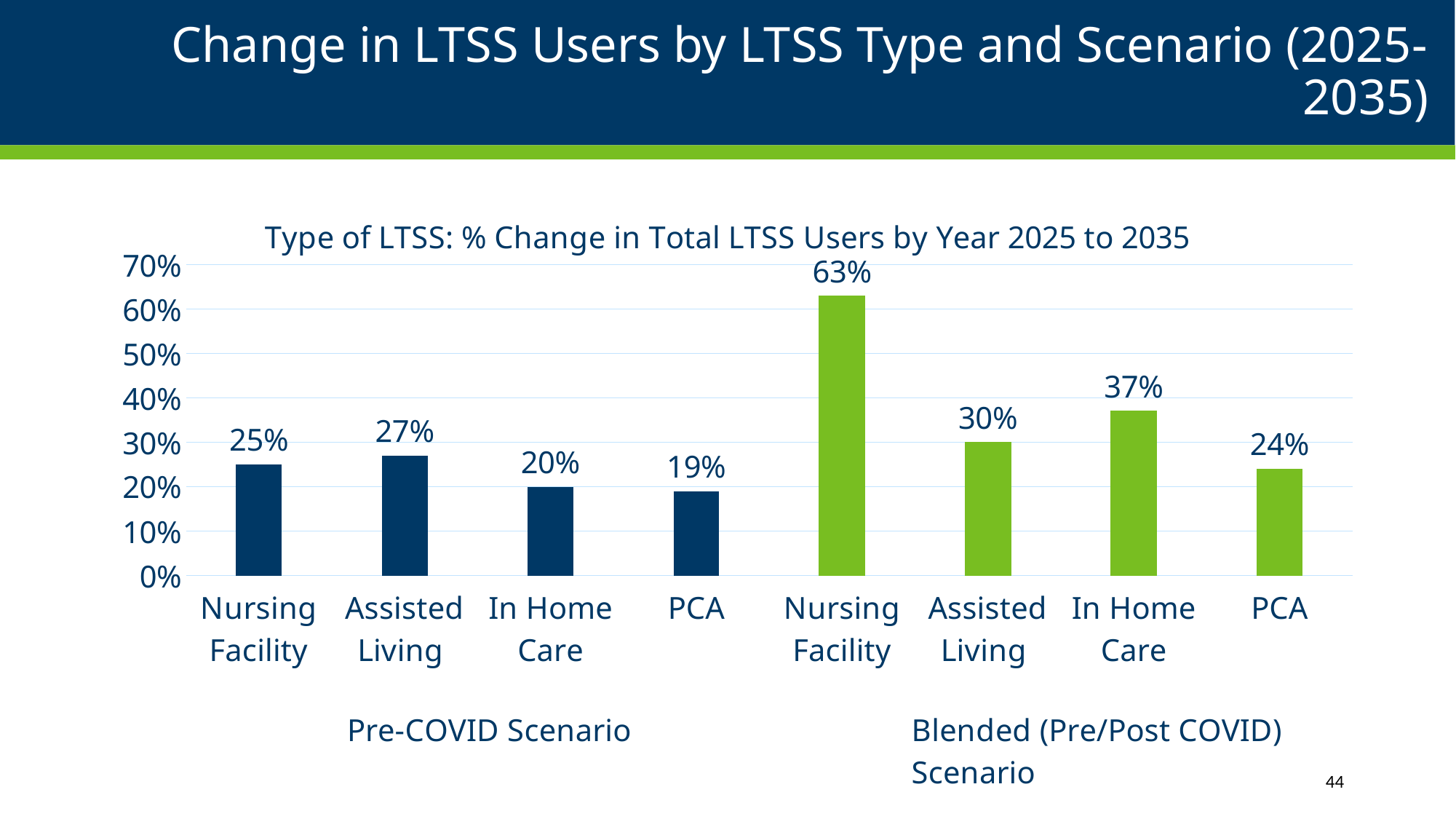
What kind of chart is shown on the slide? bar chart What is the value for PCA in the Pre-COVID Scenario? 19% Which bar has the lowest value on the chart? PCA (Pre-COVID Scenario) What is the difference between the Nursing Facility values in the Blended scenario and the Pre-COVID scenario? 38% What is the value for In Home Care in the Blended (Pre/Post COVID) Scenario? 37% What is the title of the chart? Type of LTSS: % Change in Total LTSS Users by Year 2025 to 2035 How many bars are plotted on the chart? 8 What is the value for Assisted Living in the Blended (Pre/Post COVID) Scenario? 30% Which is larger: Assisted Living in the Pre-COVID Scenario or Assisted Living in the Blended (Pre/Post COVID) Scenario? Assisted Living in the Blended (Pre/Post COVID) Scenario Is the value for In Home Care in the Pre-COVID Scenario greater or less than 30%? less Which bar has the highest value on the chart? Nursing Facility (Blended (Pre/Post COVID) Scenario) What is the value for Nursing Facility in the Pre-COVID Scenario? 25%